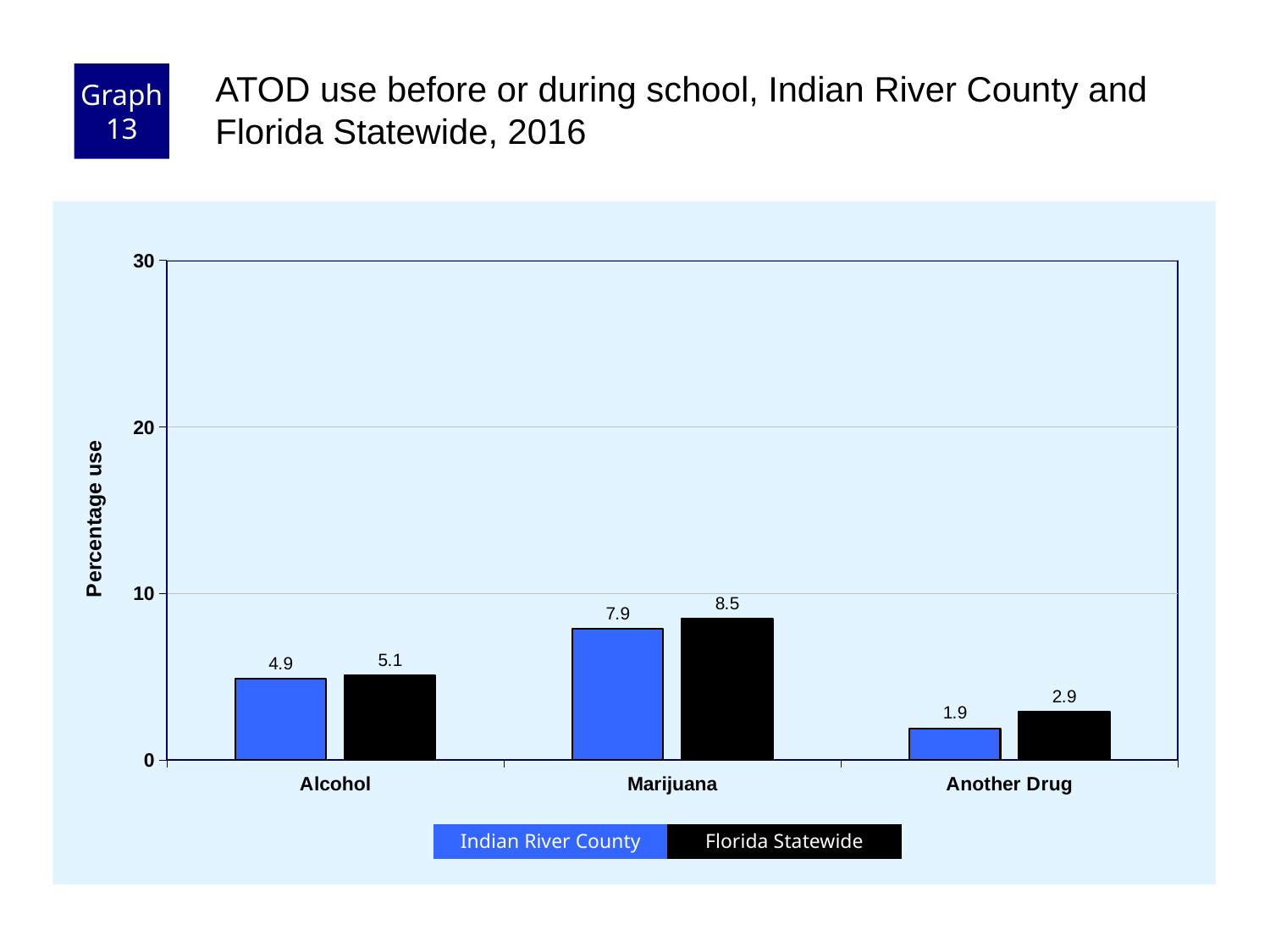
What is the Florida Statewide value for Another Drug? 2.9 What is the difference between the Florida Statewide and Indian River County values for Another Drug? 1.0 How many categories are shown on the x axis? 3 How many series does the legend list? 2 Which category has the lowest Indian River County value? Another Drug Which category has the highest Florida Statewide value? Marijuana What is the label of the y axis? Percentage use What is the Indian River County value for Marijuana? 7.9 What is the Indian River County value for Alcohol? 4.9 Which is larger for Marijuana: Indian River County or Florida Statewide? Florida Statewide Is the Florida Statewide value for Marijuana greater or less than 10? less What kind of chart is shown on the slide? Bar chart